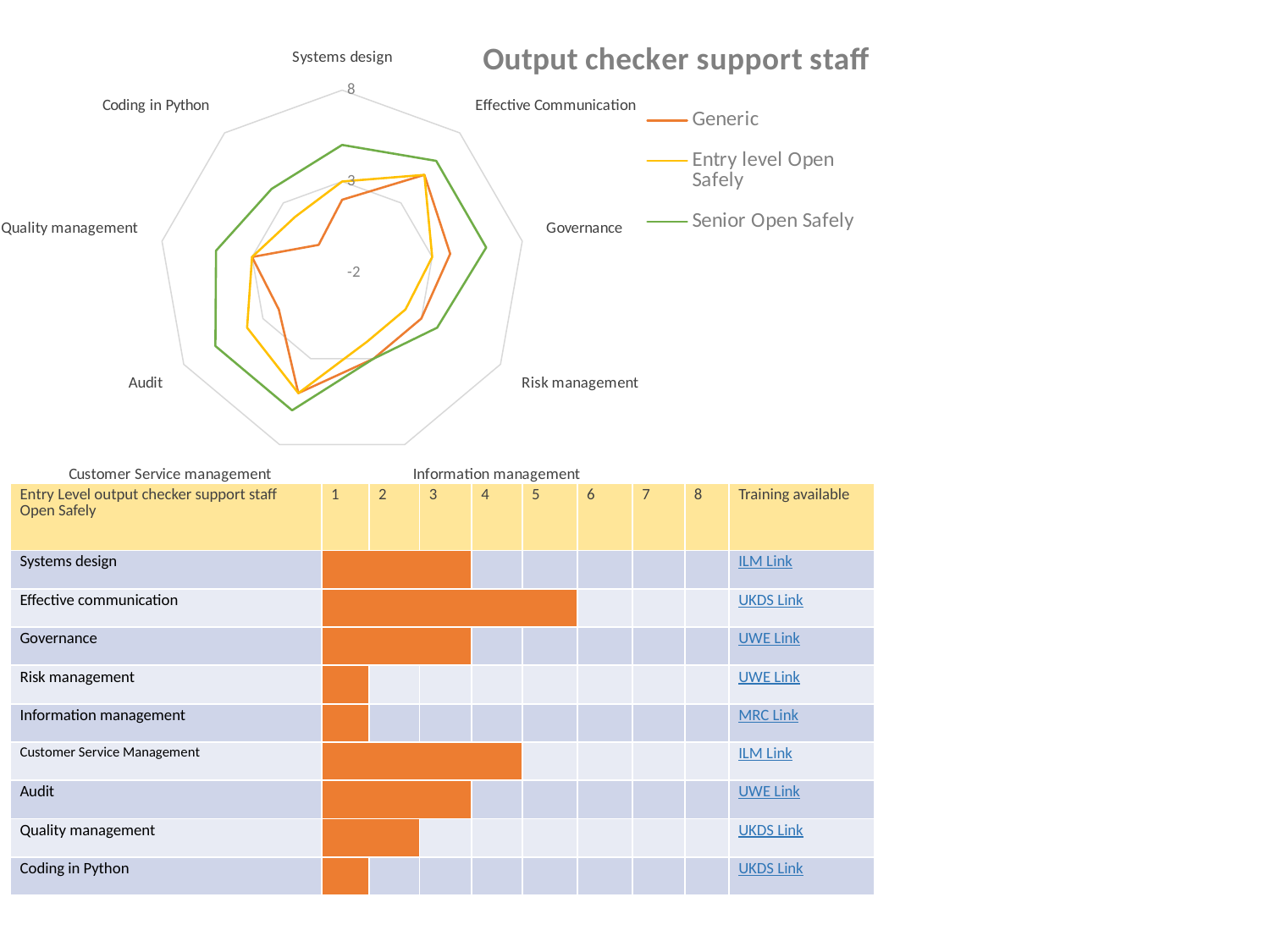
Is the Entry level Open Safely value for Customer Service management greater or less than 3? greater Is the Senior Open Safely value for Systems design greater or less than 3? greater How many categories (axes) does the radar chart have? 9 Is the Senior Open Safely value for Governance greater or less than 3? greater Which series is drawn in green on the chart? Senior Open Safely Which series has the lowest value for Coding in Python? Generic What kind of chart is shown on the slide? Radar chart What is the title of the chart? Output checker support staff For Systems design, which is larger: the Senior Open Safely value or the Generic value? Senior Open Safely Which series has the highest value for Quality management? Senior Open Safely How many series does the chart's legend list? 3